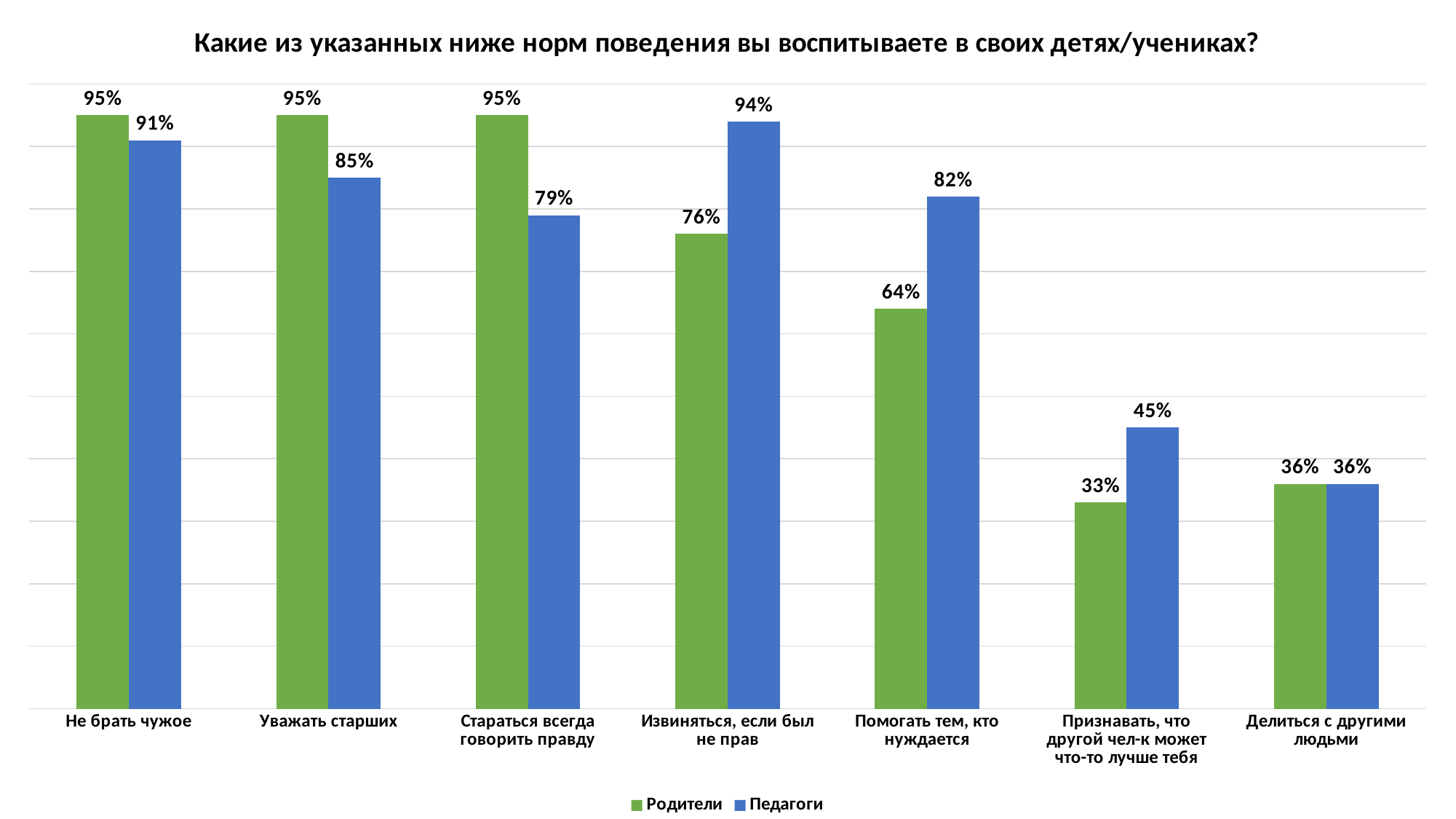
Which colour represents Педагоги in the chart? Blue What is the difference between Педагоги and Родители for «Помогать тем, кто нуждается»? 18% How many categories are shown on the x axis? 7 What is the difference between Родители and Педагоги for «Уважать старших»? 10% Which category has the highest value for Педагоги? Извиняться, если был не прав For «Извиняться, если был не прав», which group has the larger value, Родители or Педагоги? Педагоги What kind of chart is shown on the slide? Bar chart What percentage of Педагоги chose «Помогать тем, кто нуждается»? 82% Which category has the lowest value for Родители? Признавать, что другой чел-к может что-то лучше тебя What percentage of Родители chose «Не брать чужое»? 95% How many series does the legend list? 2 What is the value for Педагоги for «Стараться всегда говорить правду»? 79%